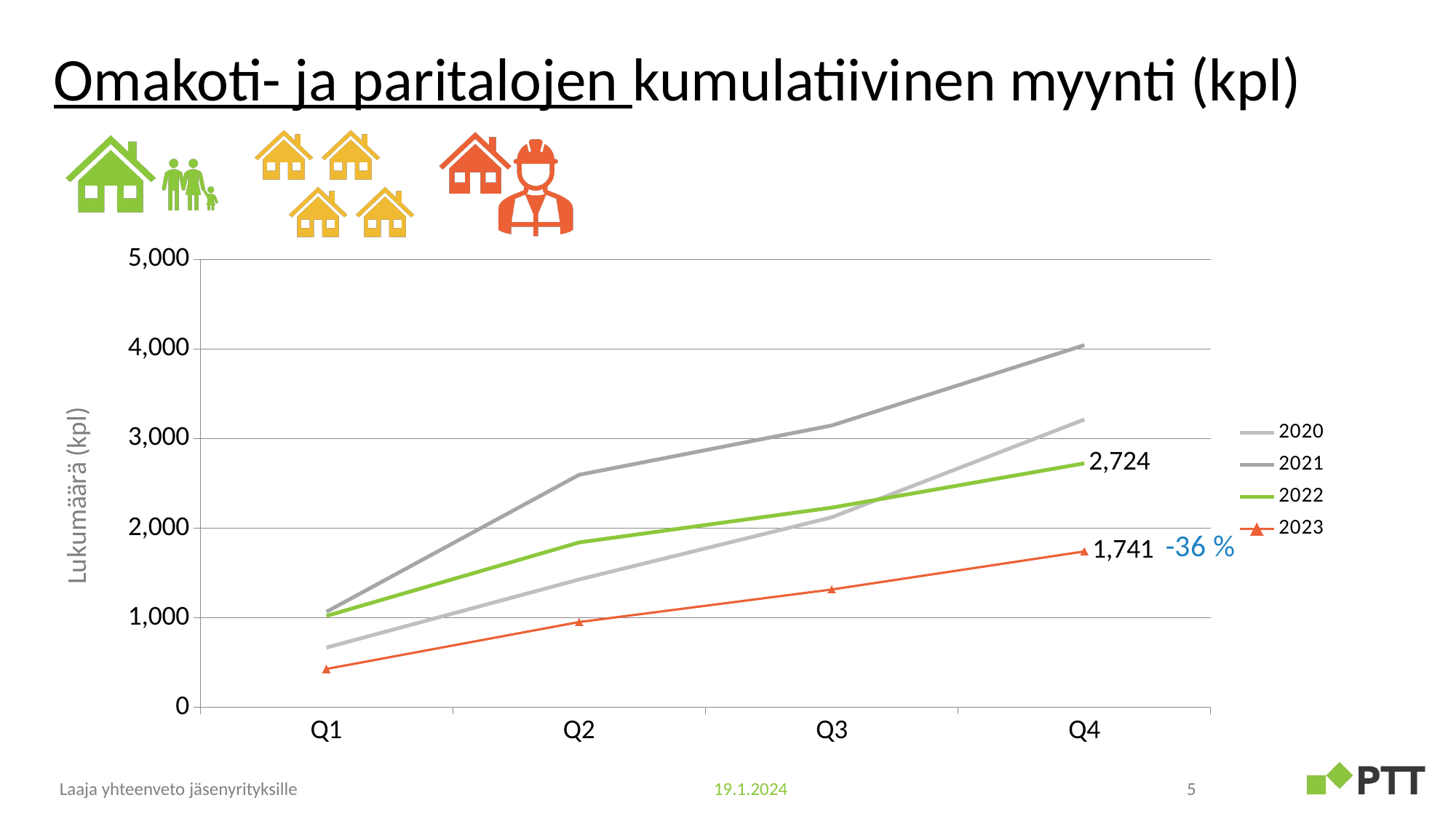
How many series does the legend list? 4 Is the value for 2020 at Q1 greater or less than 1,000? less What is the value for 2022 at Q4? 2,724 What percentage change is annotated next to the 2023 line at Q4? -36 % Which series has the highest value at Q4? 2021 Which series has the lowest value at Q4? 2023 How many quarters are shown on the x axis? 4 What is the difference between the 2022 and 2023 values at Q4? 983 Is the value for 2021 at Q2 greater or less than 2,000? greater What is the value for 2023 at Q4? 1,741 What type of chart is shown on the slide? line chart Which is larger at Q2, the value for 2021 or the value for 2020? 2021